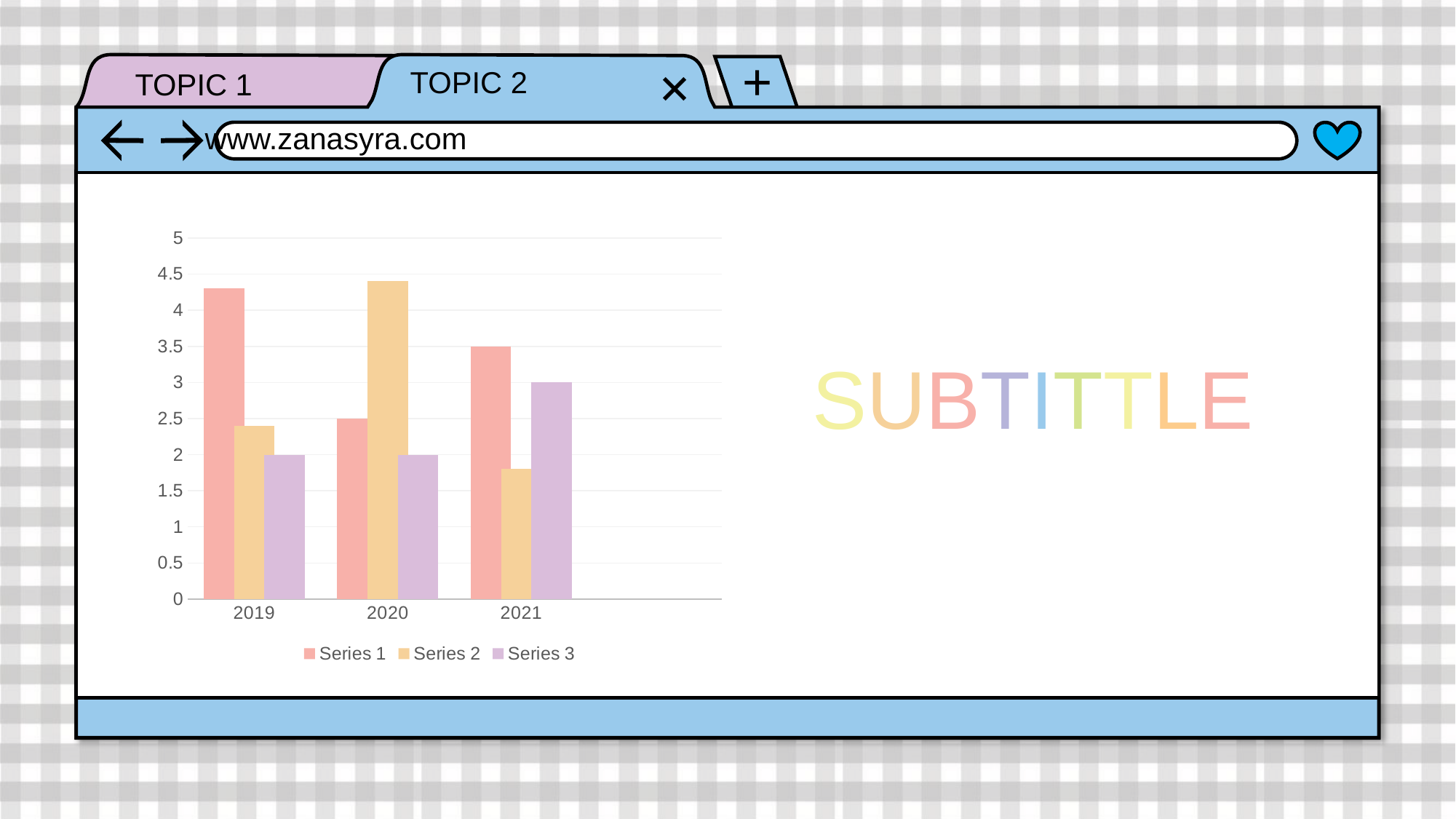
What is the difference between Series 1 in 2021 and Series 3 in 2021? 0.5 Which series has the highest value in 2020? Series 2 What kind of chart is shown on the slide? bar chart What is the value of Series 3 for 2021? 3 What is the value of Series 1 for 2020? 2.5 Is the value for Series 2 in 2021 greater or less than 2? less What is the value of Series 3 for 2019? 2 Which series has the lowest value in 2021? Series 2 How many series does the chart's legend list? 3 Is the value for Series 2 in 2020 greater or less than 4? greater Which is larger in 2019, Series 1 or Series 3? Series 1 How many categories are shown on the x axis of the chart? 3